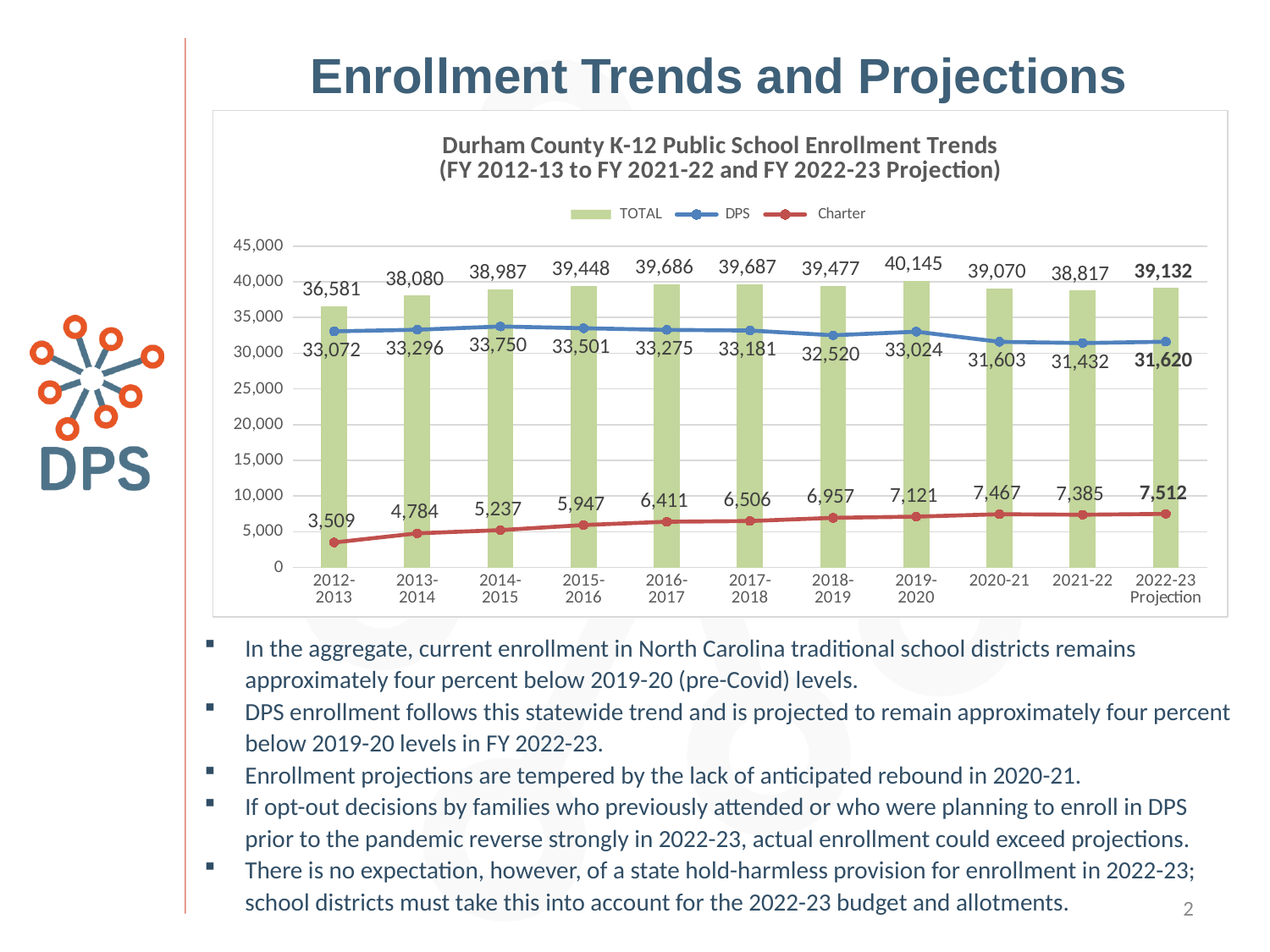
Does the Charter enrollment generally rise or fall from 2012-2013 to the 2022-23 projection? Rise What is the difference between DPS enrollment in 2019-2020 and the 2022-23 projection? 1,404 What is the Charter enrollment value for 2012-2013? 3,509 Which year has the larger DPS enrollment, 2014-2015 or 2015-2016? 2014-2015 In which year is the TOTAL enrollment highest? 2019-2020 What is the TOTAL enrollment value for 2019-2020? 40,145 How many series does the legend list? 3 What is the projected DPS enrollment for 2022-23? 31,620 What kind of chart is this? Combination bar and line chart In which year is the DPS enrollment highest? 2014-2015 How many years (categories) are shown on the x axis? 11 In which year is the Charter enrollment lowest? 2012-2013